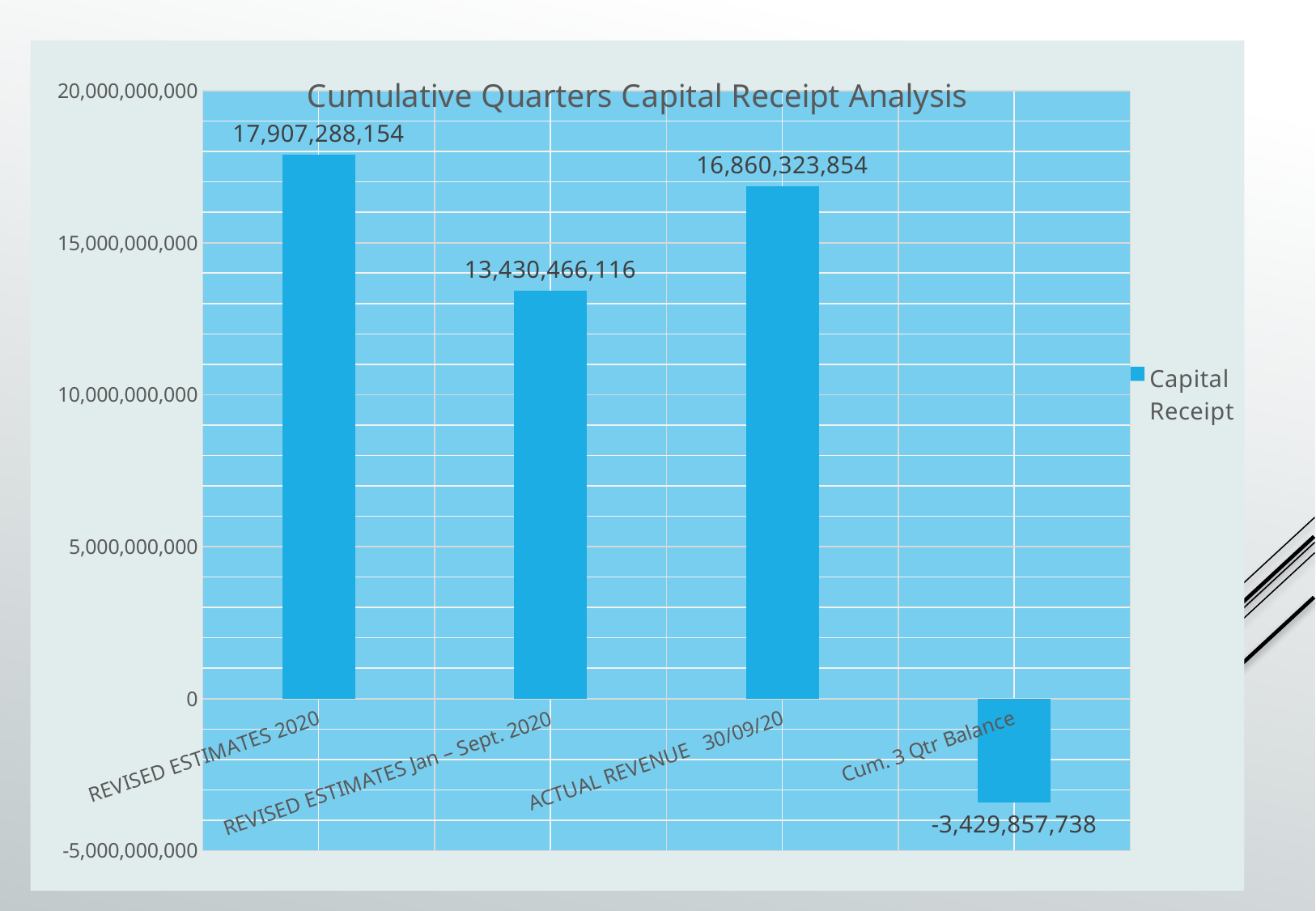
What is the difference between ACTUAL REVENUE 30/09/20 and REVISED ESTIMATES Jan – Sept. 2020? 3,429,857,738 Which category has the lowest value? Cum. 3 Qtr Balance Which is larger, REVISED ESTIMATES Jan – Sept. 2020 or ACTUAL REVENUE 30/09/20? ACTUAL REVENUE 30/09/20 What is the value for ACTUAL REVENUE 30/09/20? 16,860,323,854 What is the value for REVISED ESTIMATES 2020? 17,907,288,154 What kind of chart is this? Bar chart What is the title of the chart? Cumulative Quarters Capital Receipt Analysis What is the value for Cum. 3 Qtr Balance? -3,429,857,738 What is the value for REVISED ESTIMATES Jan – Sept. 2020? 13,430,466,116 Which category has the highest value? REVISED ESTIMATES 2020 How many categories are shown on the x axis? 4 What is the difference between REVISED ESTIMATES 2020 and ACTUAL REVENUE 30/09/20? 1,046,964,300